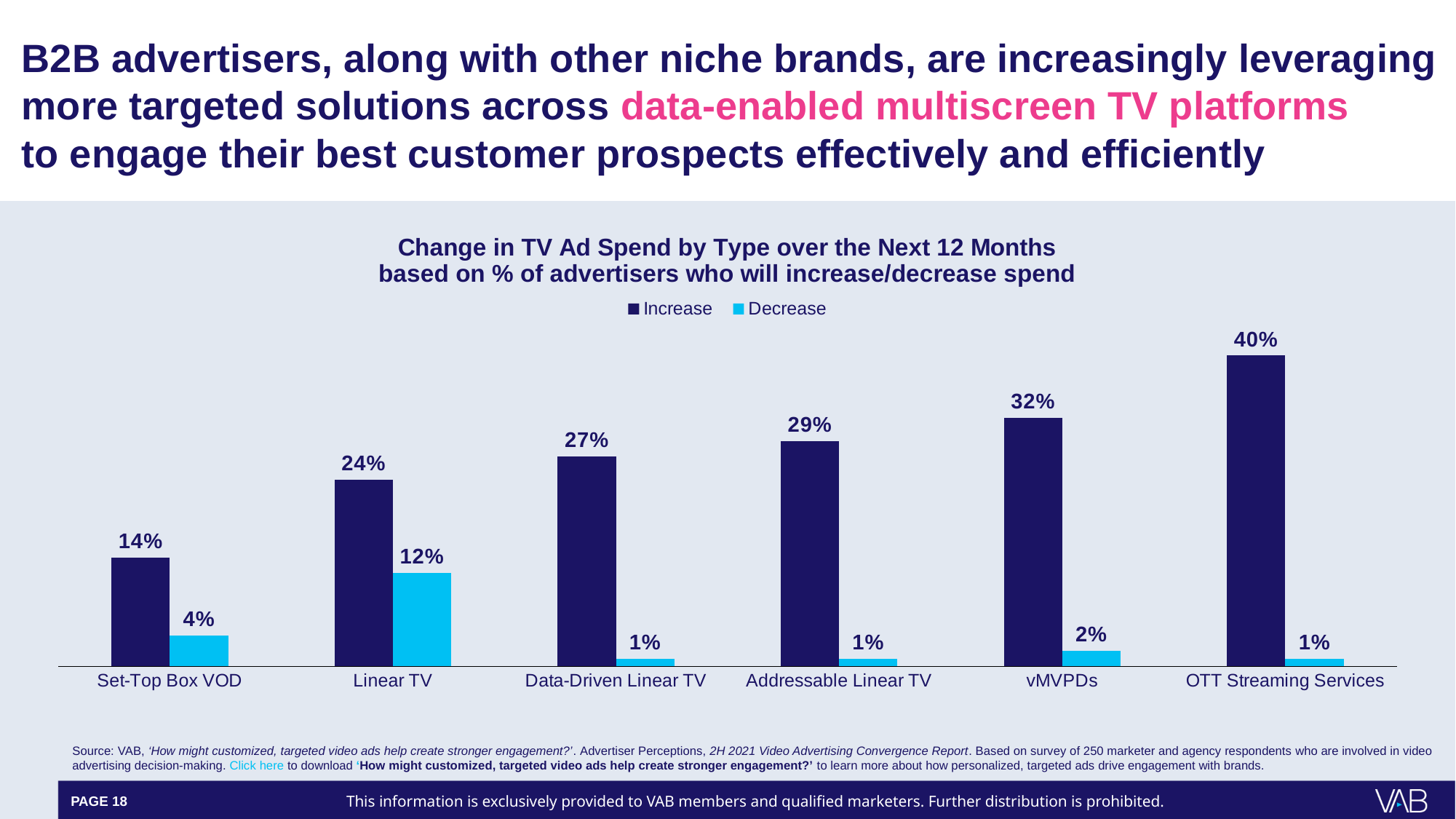
Which category has the lowest Increase value? Set-Top Box VOD How many series does the legend list? 2 What is the difference between the Increase values for vMVPDs and Set-Top Box VOD? 18% Do the Increase values rise or fall from left to right across the categories? Rise Which category has the highest Decrease value? Linear TV What percentage of advertisers will increase spend on OTT Streaming Services? 40% How many categories are shown on the x axis? 6 What kind of chart is shown on the slide? Bar chart What is the Decrease value for Linear TV? 12% Which has a larger Increase value, Data-Driven Linear TV or Linear TV? Data-Driven Linear TV Which category has the highest Increase value? OTT Streaming Services What is the Increase value for Addressable Linear TV? 29%